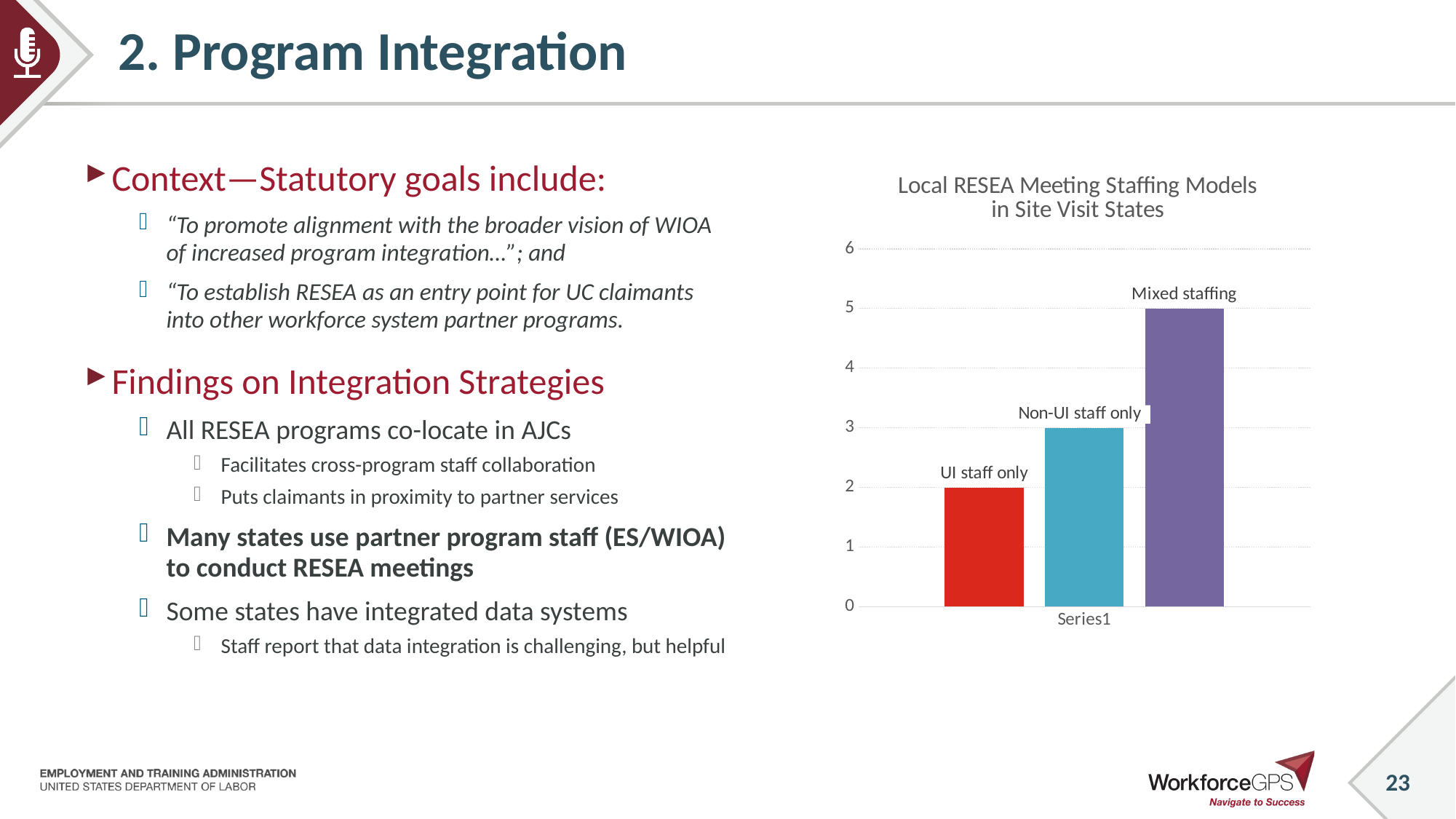
What is the value for UI staff only? 2 What is the value for Non-UI staff only? 3 How many bars are plotted in the chart? 3 What type of chart is shown on the slide? bar chart Which staffing model has the highest value? Mixed staffing What is the title of the chart? Local RESEA Meeting Staffing Models in Site Visit States What is the value for Mixed staffing? 5 Which staffing model has the lowest value? UI staff only Which is larger, the value for Non-UI staff only or the value for UI staff only? Non-UI staff only Is the value for Mixed staffing greater or less than 4? greater What is the difference between the values for Mixed staffing and UI staff only? 3 What is the label shown on the x axis beneath the bars? Series1